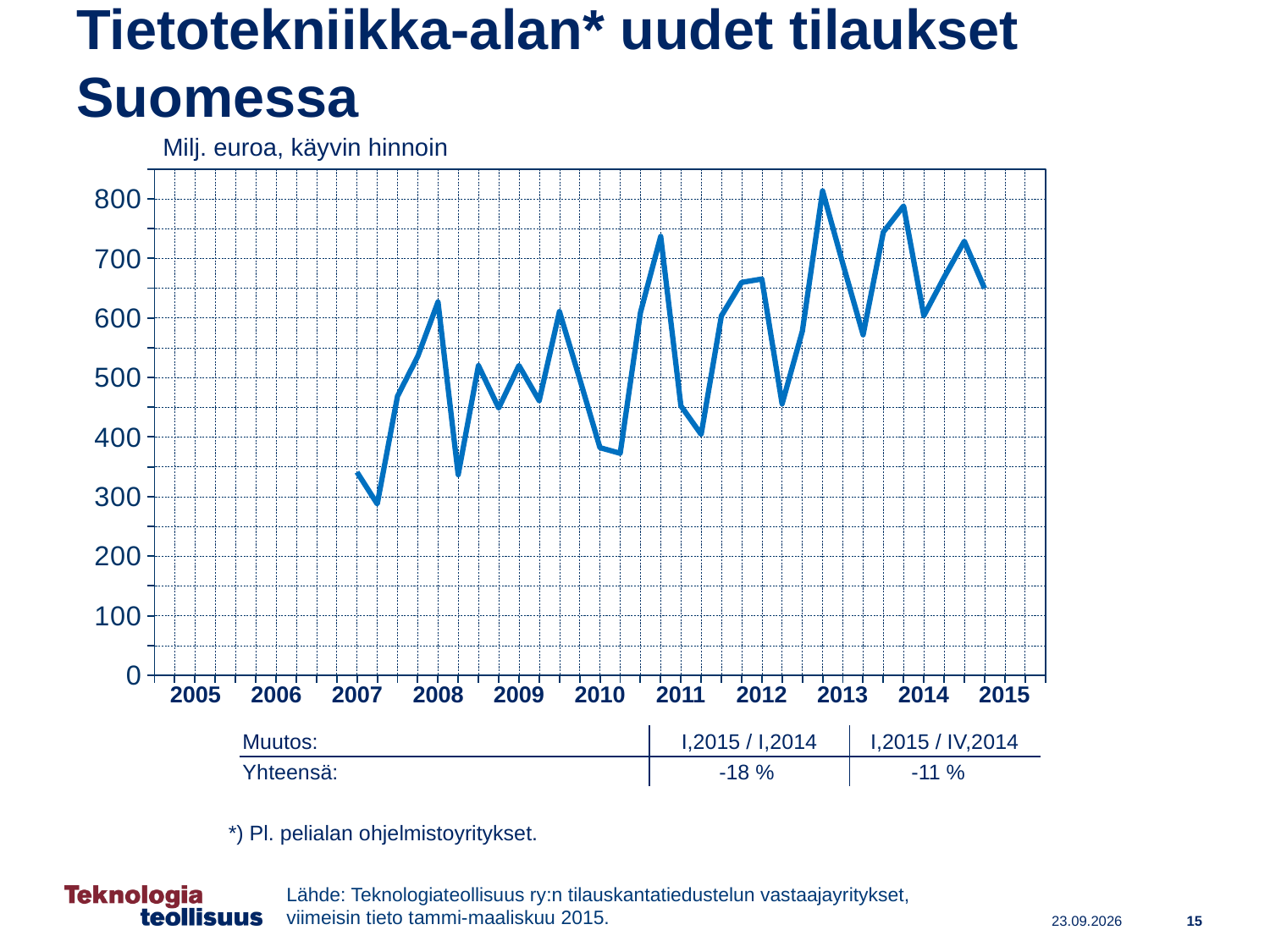
Is the last plotted value, in 2015, greater or less than 600? greater According to the table below the chart, what is the change (Yhteensä) for I,2015 / IV,2014? -11 % Is the first plotted value, at the start of 2007, greater or less than 400? less Is the lowest point of the line greater or less than 400? less What kind of chart is shown on the slide? line chart What unit label is shown above the y axis of the chart? Milj. euroa, käyvin hinnoin What is the title of the chart on the slide? Tietotekniikka-alan* uudet tilaukset Suomessa In which year does the line reach its lowest point? 2007 Overall, do the values rise or fall from the start of the line in 2007 to its end in 2015? rise How many year labels are shown on the x axis of the chart? 11 According to the table below the chart, what is the change (Yhteensä) for I,2015 / I,2014? -18 %